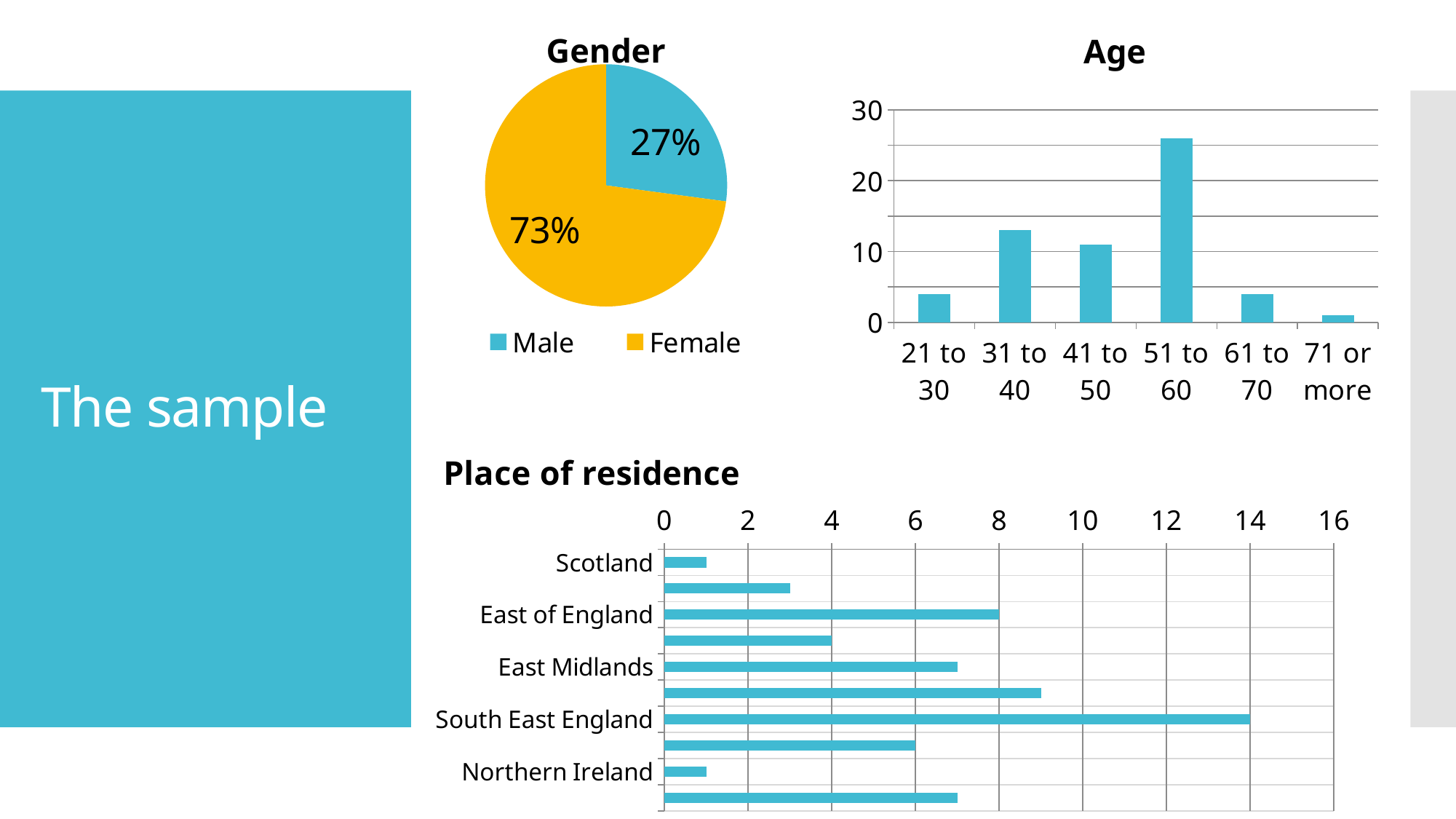
On the Age chart, which age group has the lowest value? 71 or more On the Age chart, which age group has the highest value? 51 to 60 On the Age chart, is the value for 51 to 60 greater or less than 20? greater On the Gender chart, what share of the sample is Male? 27% On the Gender chart, which is larger, the Male slice or the Female slice? Female On the Gender chart, what share of the sample is Female? 73% On the Gender chart, what is the difference between the Female and Male percentages? 46% On the Age chart, is the value for 21 to 30 greater or less than 10? less On the Place of residence chart, what is the value for South East England? 14 What kind of chart is the Gender chart? Pie chart On the Age chart, how many age groups are shown? 6 On the Place of residence chart, what is the difference between South East England and East of England? 6